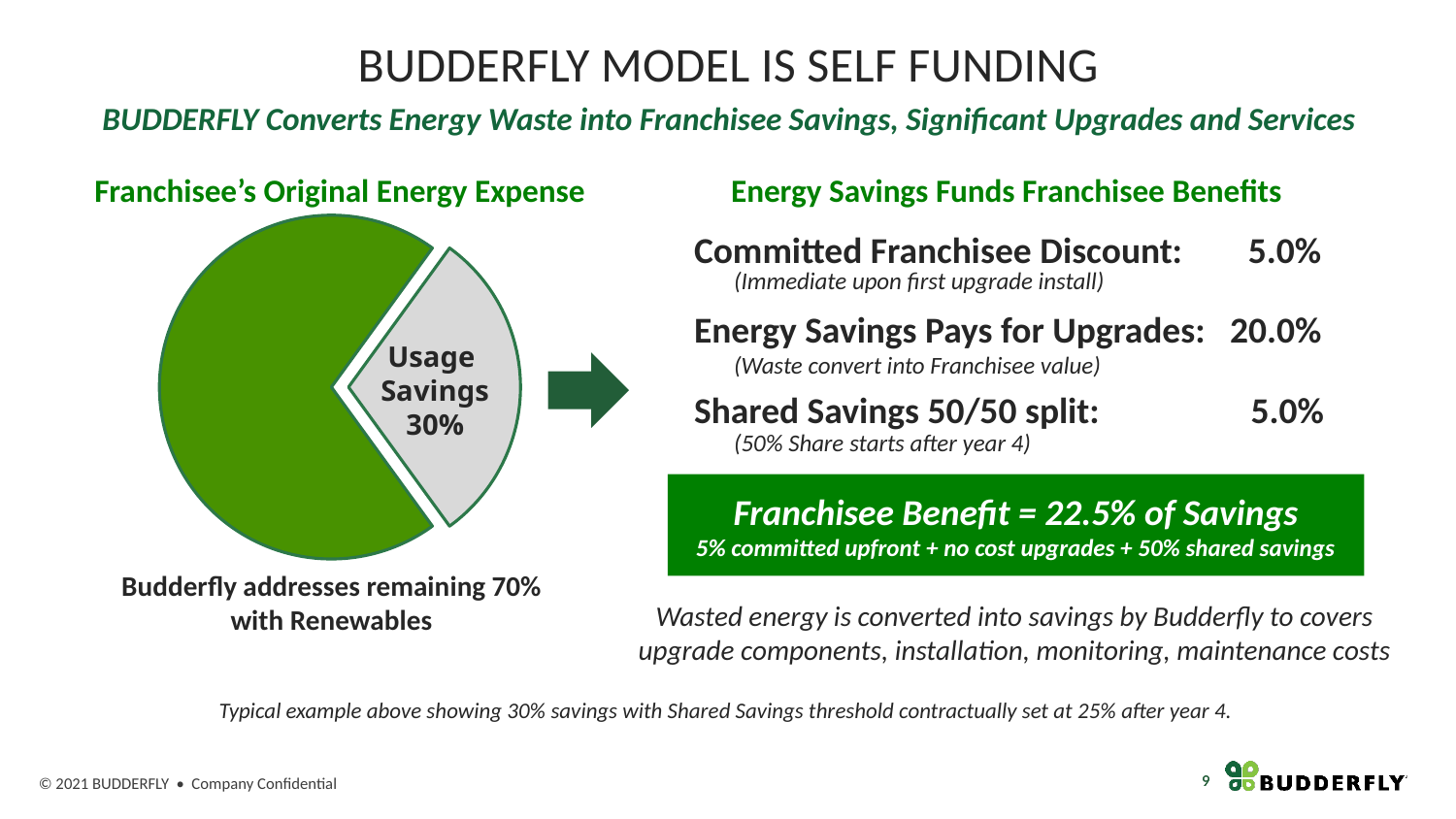
Is the "Usage Savings" slice of the pie chart greater or less than 50% of the pie? less What percentage is shown for the "Usage Savings" slice of the pie chart? 30% What is the title shown above the pie chart? Franchisee's Original Energy Expense What share of the pie chart does the "Usage Savings" slice represent? 30% What colour is the "Usage Savings" slice of the pie chart? Grey What is the difference between the share Budderfly addresses with Renewables (70%) and the Usage Savings share (30%) in the pie chart? 40% Which slice of the pie chart is larger, the green slice or the grey "Usage Savings" slice? The green slice What kind of chart is shown under the heading "Franchisee's Original Energy Expense"? Pie chart According to the text below the pie chart, what percentage of the original energy expense does Budderfly address with Renewables? 70% How many slices does the pie chart have? 2 Which slice of the pie chart is the smallest? Usage Savings